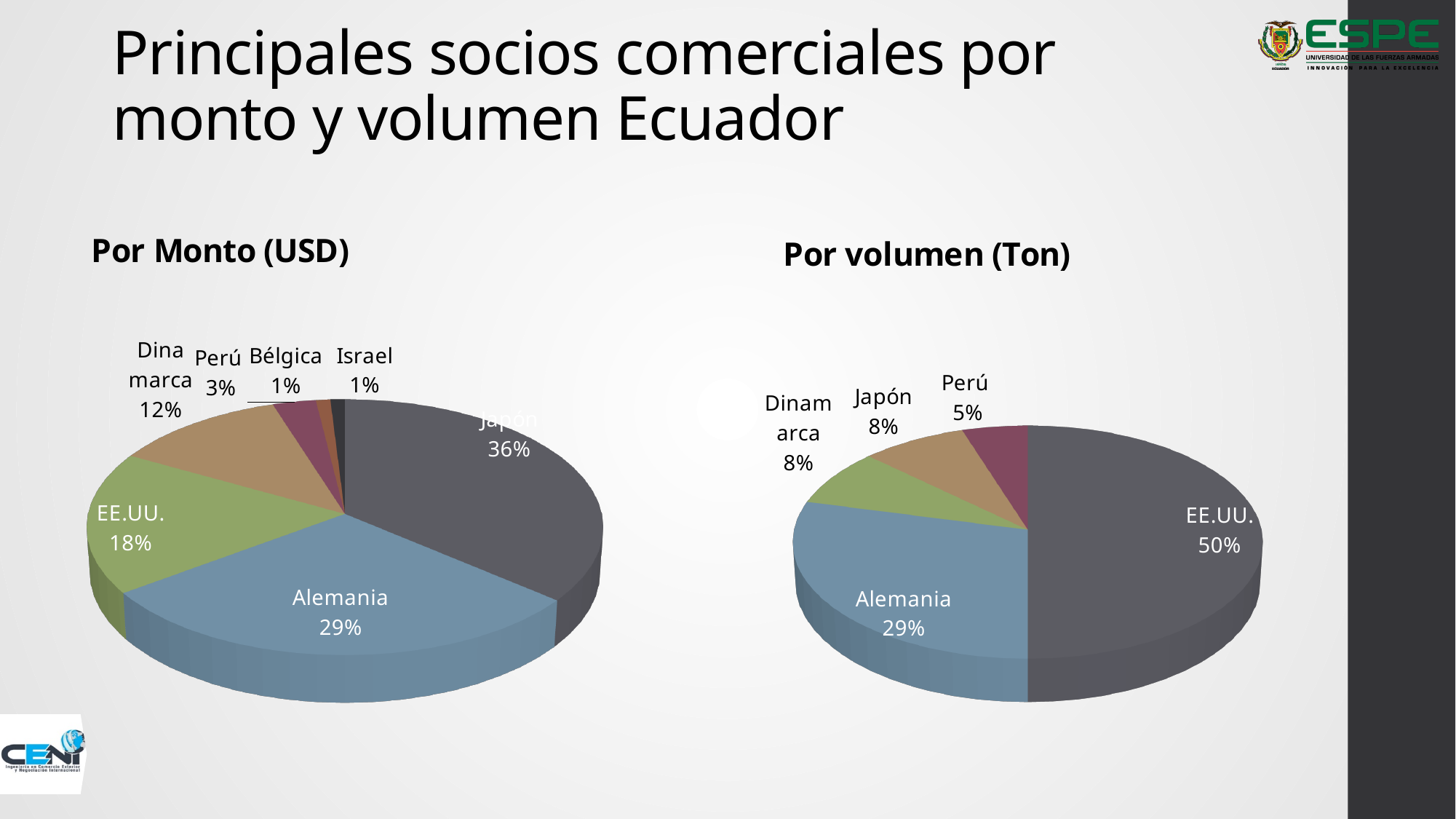
In the 'Por Monto (USD)' chart, how many countries are shown? 7 What type of chart is used on this slide? Pie chart In the 'Por Monto (USD)' chart, what share does EE.UU. have? 18% In the 'Por Monto (USD)' chart, what share does Dinamarca have? 12% In the 'Por volumen (Ton)' chart, which country has the smallest share? Perú In the 'Por volumen (Ton)' chart, how many countries are shown? 5 In the 'Por volumen (Ton)' chart, what is the difference between the shares of EE.UU. and Alemania? 21% Which is larger: the share of EE.UU. in the 'Por Monto (USD)' chart or in the 'Por volumen (Ton)' chart? Por volumen (Ton) In the 'Por volumen (Ton)' chart, what share does EE.UU. have? 50% In the 'Por Monto (USD)' chart, what share does Japón have? 36% In the 'Por Monto (USD)' chart, which country has the largest share? Japón In the 'Por Monto (USD)' chart, what is the difference between the shares of Alemania and EE.UU.? 11%